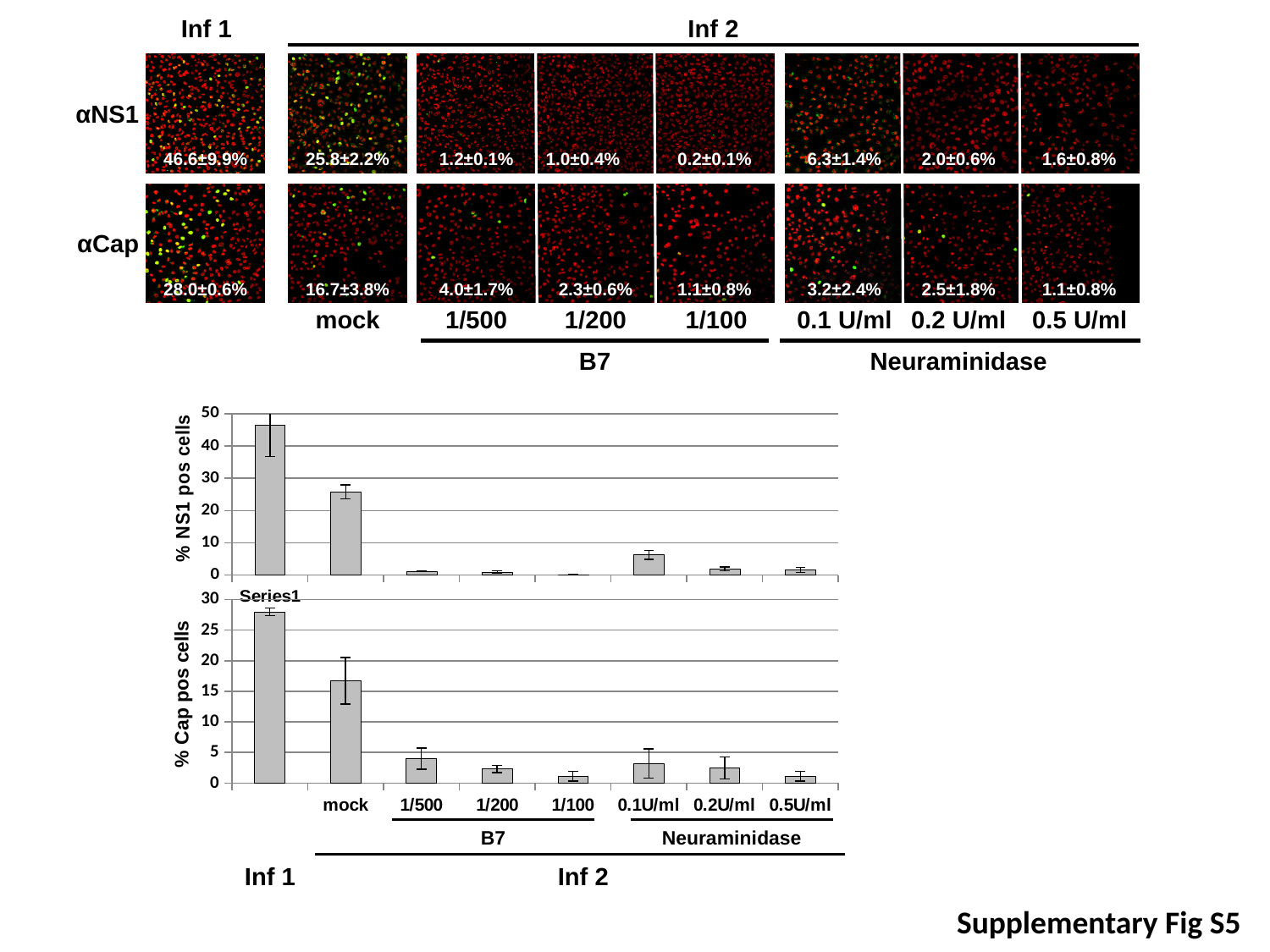
In the bottom chart (% Cap pos cells), is the value for mock greater or less than 10? greater How many bars are plotted in the top chart (% NS1 pos cells)? 8 In the top chart (% NS1 pos cells), is the value for Inf 1 greater or less than 40? greater In the bottom chart (% Cap pos cells), is the value for Inf 1 greater or less than 25? greater In the bottom chart (% Cap pos cells), which category has the highest value? Inf 1 In the top chart (% NS1 pos cells), which category has the highest value? Inf 1 What kind of chart is the top chart labelled '% NS1 pos cells'? bar chart In the top chart (% NS1 pos cells), which is larger, the value for mock or the value for 0.1U/ml? mock In the top chart (% NS1 pos cells), do the values rise or fall across the B7 dilutions from 1/500 to 1/100? fall What is the y-axis label of the bottom chart? % Cap pos cells In the bottom chart (% Cap pos cells), which is larger, the value for 1/500 or the value for 1/100? 1/500